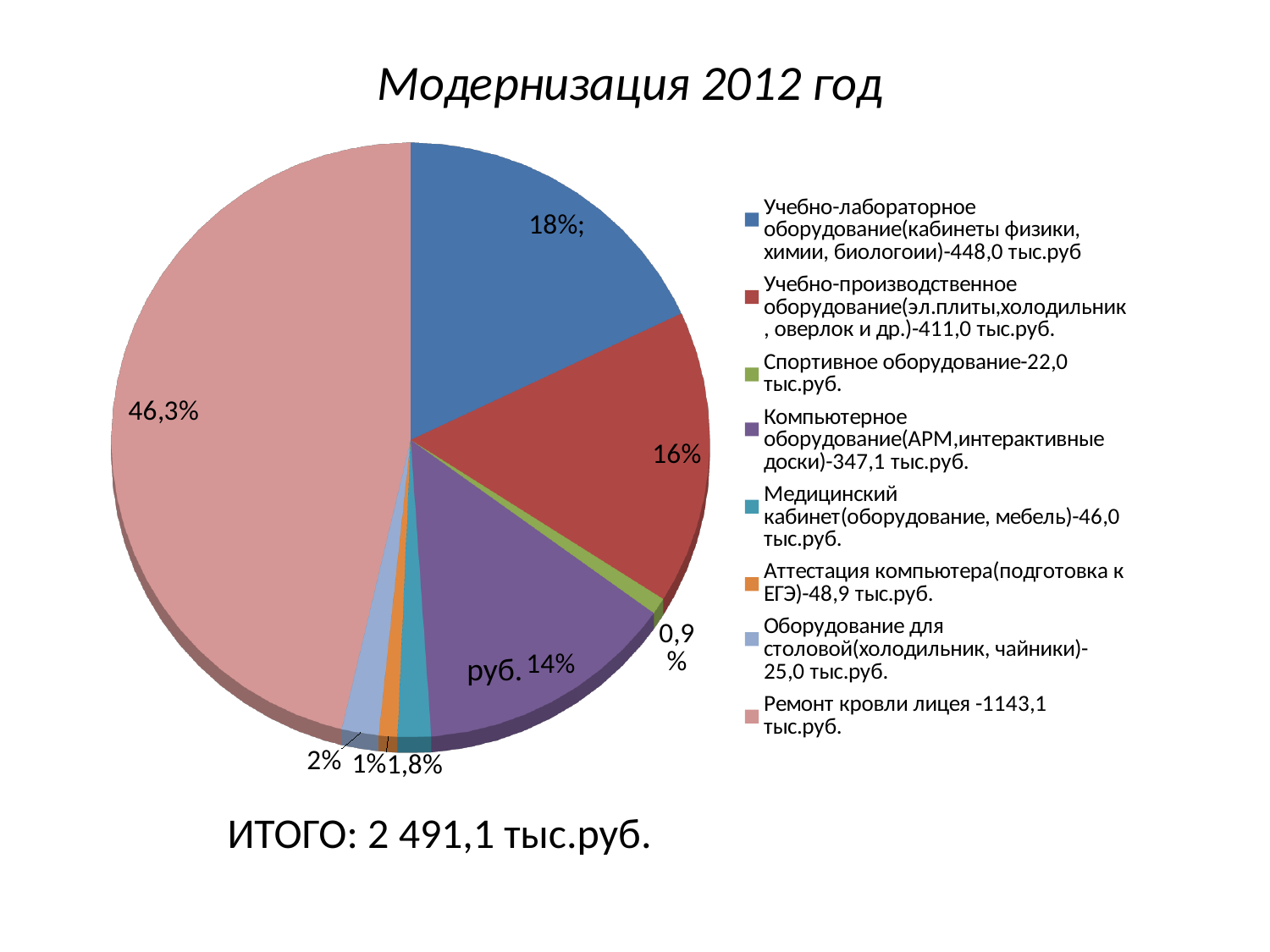
Which category has the largest share of the pie? Ремонт кровли лицея What kind of chart is shown on the slide? pie chart What share of the pie does Ремонт кровли лицея take? 46,3% What is the title of the chart? Модернизация 2012 год Which is larger: the share for Учебно-лабораторное оборудование or for Учебно-производственное оборудование? Учебно-лабораторное оборудование According to the legend, what amount was spent on Учебно-производственное оборудование? 411,0 тыс.руб. How many slices does the pie chart have? 8 What share of the pie does Компьютерное оборудование take? 14% What is the total amount (ИТОГО) shown on the slide? 2 491,1 тыс.руб. What share of the pie does Учебно-лабораторное оборудование take? 18% How many entries does the legend list? 8 Which category has the smallest share of the pie? Спортивное оборудование